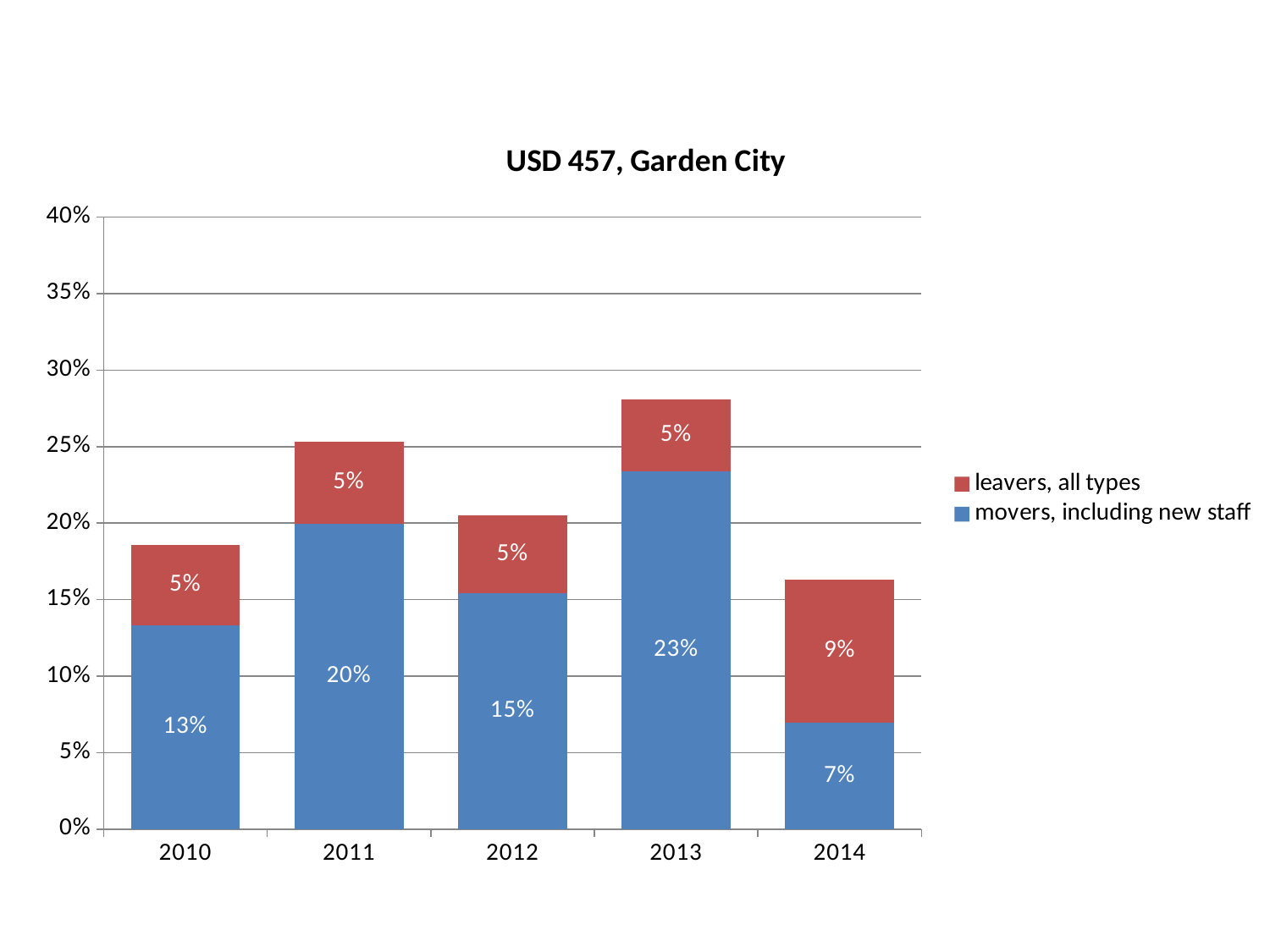
How many years are shown on the x axis? 5 Which year has the highest value for leavers, all types? 2014 How many series does the legend list? 2 Is the total height of the 2013 bar greater or less than 25%? greater What kind of chart is shown on the slide? Stacked bar chart What is the value for movers, including new staff in 2011? 20% What is the difference between the movers, including new staff values for 2013 and 2014? 16% Which year has the lowest value for movers, including new staff? 2014 What is the value for movers, including new staff in 2013? 23% Which year has the larger value for movers, including new staff: 2011 or 2012? 2011 Which year has the highest value for movers, including new staff? 2013 What is the value for leavers, all types in 2014? 9%